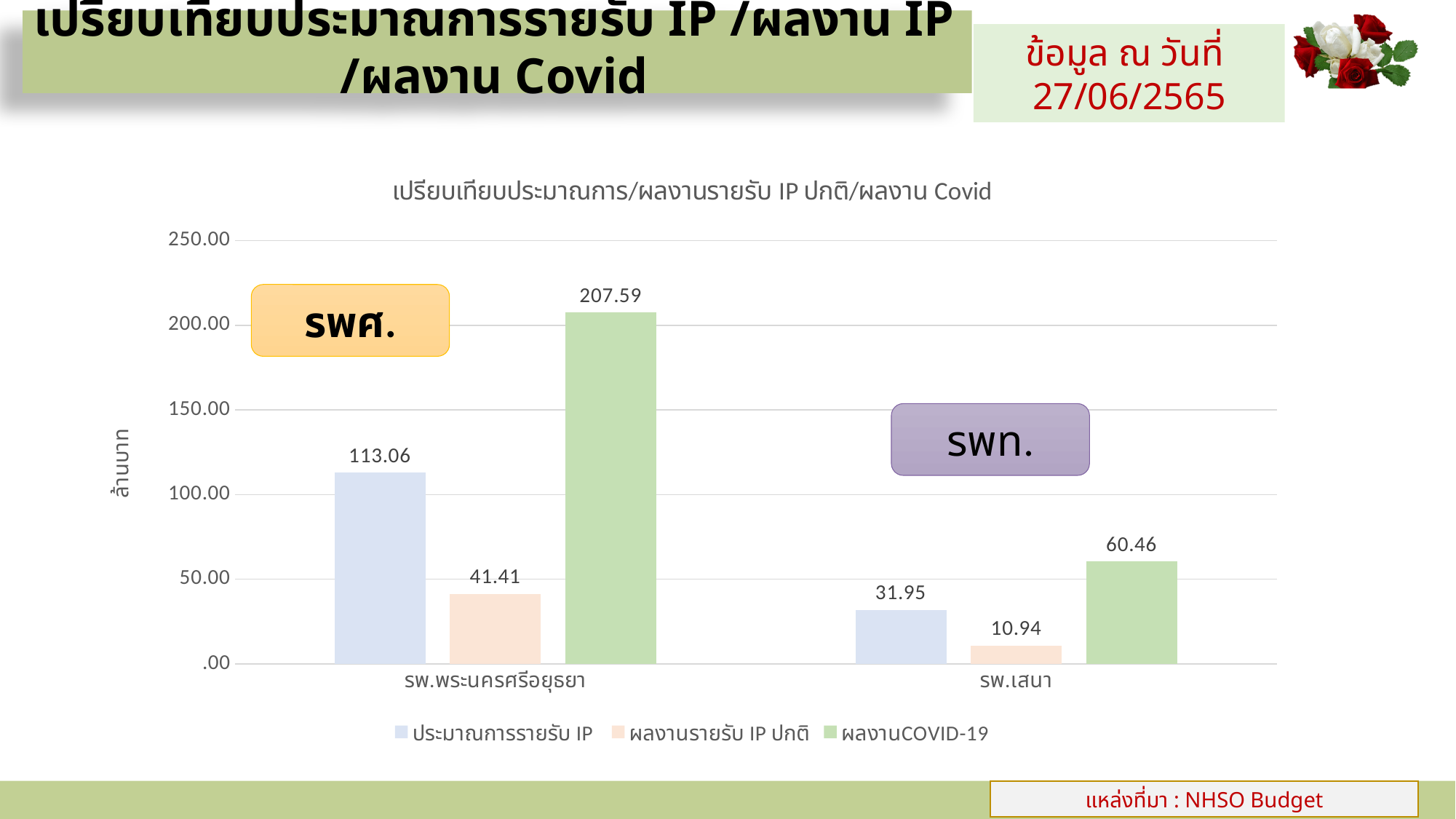
What is the difference between ประมาณการรายรับ IP and ผลงานรายรับ IP ปกติ for รพ.เสนา? 21.01 What is the value of ประมาณการรายรับ IP for รพ.พระนครศรีอยุธยา? 113.06 What type of chart is shown on the slide? Bar chart How many series does the legend list? 3 What is the difference between ผลงานCOVID-19 and ประมาณการรายรับ IP for รพ.พระนครศรีอยุธยา? 94.53 What is the value of ผลงานCOVID-19 for รพ.เสนา? 60.46 What is the value of ผลงานรายรับ IP ปกติ for รพ.พระนครศรีอยุธยา? 41.41 Which series has the highest value for รพ.พระนครศรีอยุธยา? ผลงานCOVID-19 How many hospitals (categories) are shown on the x axis? 2 Is the value of ผลงานCOVID-19 for รพ.พระนครศรีอยุธยา greater or less than 200.00? greater Which is larger: ประมาณการรายรับ IP for รพ.เสนา or ผลงานรายรับ IP ปกติ for รพ.พระนครศรีอยุธยา? ผลงานรายรับ IP ปกติ for รพ.พระนครศรีอยุธยา Which series has the lowest value for รพ.เสนา? ผลงานรายรับ IP ปกติ